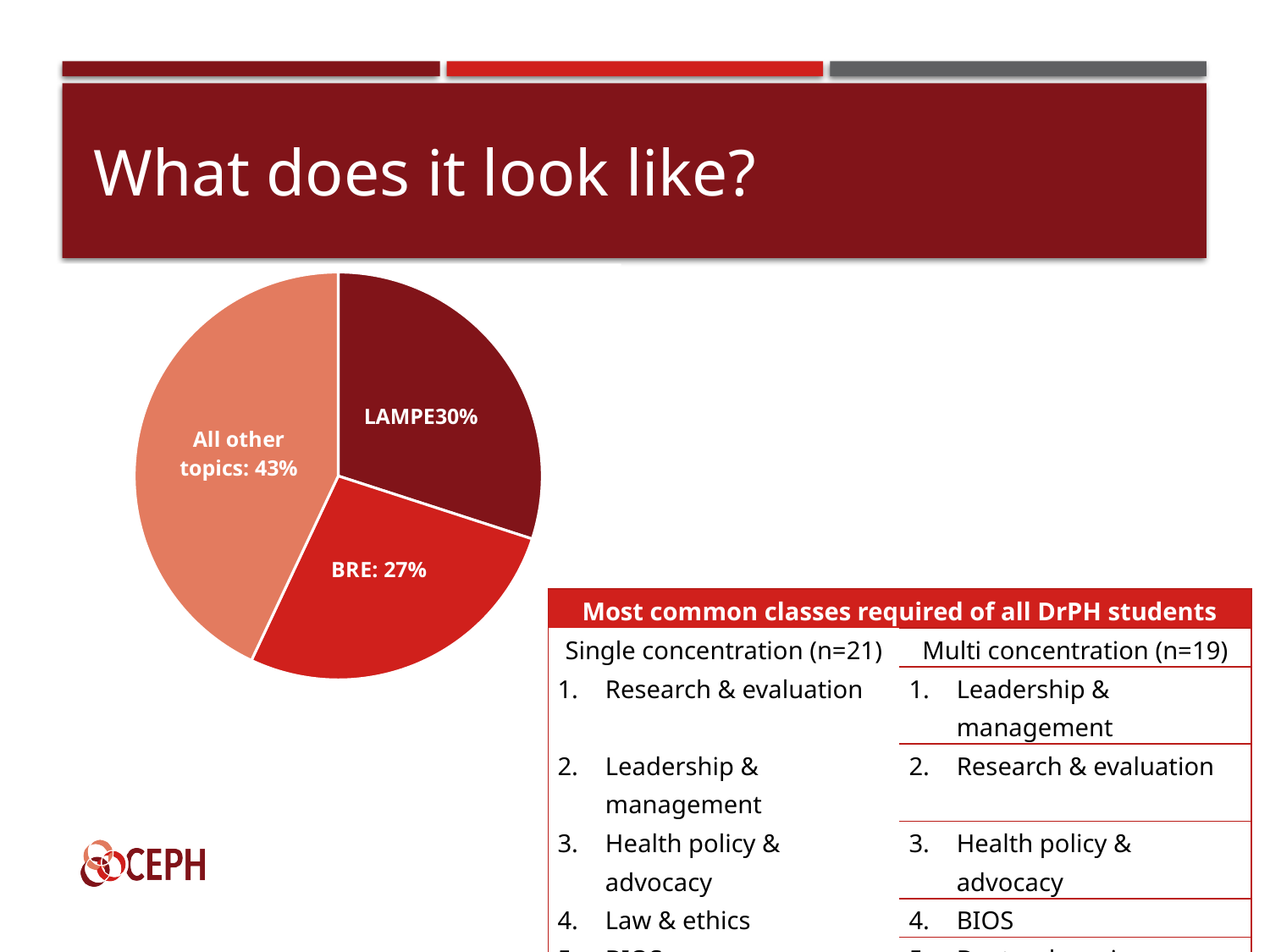
Which slice of the pie chart is the smallest? BRE What share of the pie chart is labelled All other topics? 43% What is the difference in percentage points between the All other topics slice and the LAMPE slice? 13 What share of the pie chart is labelled BRE? 27% What is the difference in percentage points between the LAMPE slice and the BRE slice? 3 Which is larger in the pie chart, the LAMPE slice or the BRE slice? LAMPE How many slices does the pie chart have? 3 What is the combined share of the LAMPE and BRE slices in the pie chart? 57% Which slice of the pie chart is the largest? All other topics What share of the pie chart is labelled LAMPE? 30% What colour is the All other topics slice in the pie chart? Light salmon/orange What kind of chart is shown on the slide? Pie chart